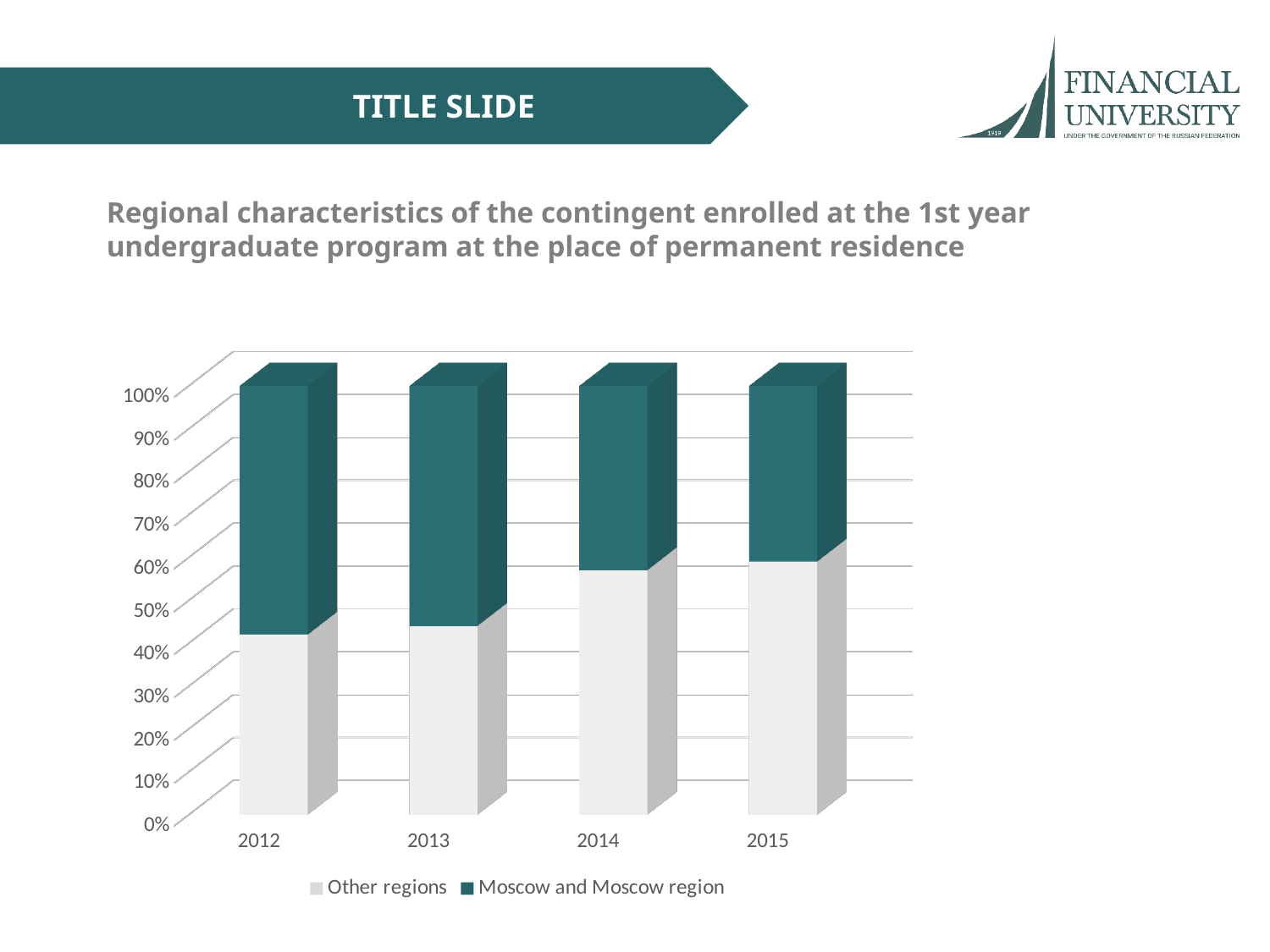
How many series does the chart legend list? 2 What is the total height of the stacked bar for 2013? 100% What kind of chart is shown on the slide? bar chart How many years are shown on the x axis of the chart? 4 Is the value for Other regions in 2015 greater or less than 50%? greater Is the value for Moscow and Moscow region in 2015 greater or less than 50%? less Which is larger, the Other regions share in 2012 or in 2015? 2015 Is the value for Moscow and Moscow region in 2012 greater or less than 50%? greater What are the two series listed in the chart legend? Other regions; Moscow and Moscow region Does the share of Other regions rise or fall from 2012 to 2015? rise